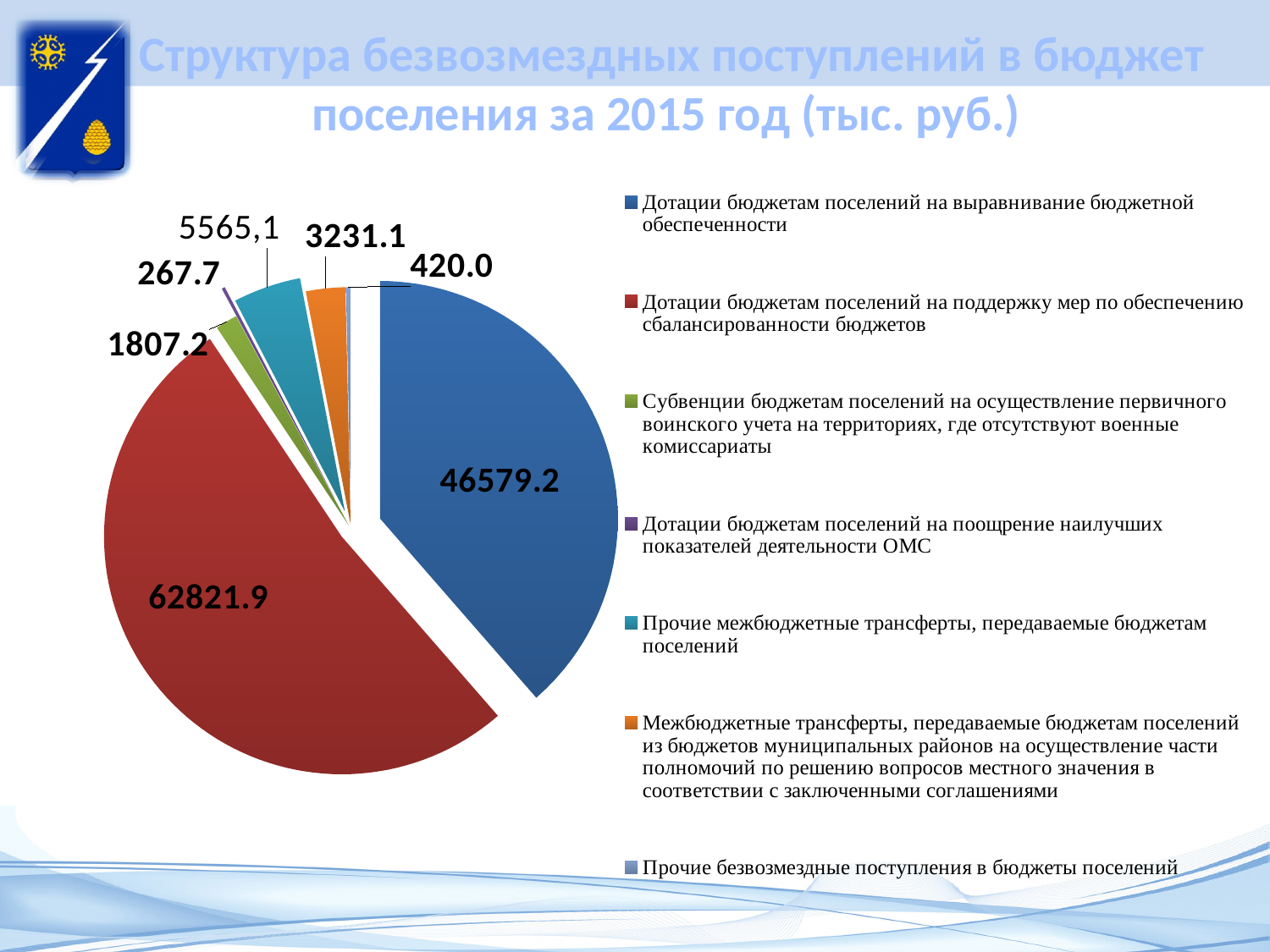
How many entries does the legend list? 7 Which category has the smallest slice of the pie? Дотации бюджетам поселений на поощрение наилучших показателей деятельности ОМС What value is shown for 'Дотации бюджетам поселений на поддержку мер по обеспечению сбалансированности бюджетов'? 62821.9 Which is larger: 'Прочие межбюджетные трансферты, передаваемые бюджетам поселений' or 'Межбюджетные трансферты из бюджетов муниципальных районов'? Прочие межбюджетные трансферты, передаваемые бюджетам поселений What value is shown for 'Прочие безвозмездные поступления в бюджеты поселений'? 420.0 What colour is the slice for 'Дотации бюджетам поселений на выравнивание бюджетной обеспеченности'? Blue What value is shown for 'Дотации бюджетам поселений на выравнивание бюджетной обеспеченности'? 46579.2 How many slices does the pie chart have? 7 What value is shown for 'Субвенции бюджетам поселений на осуществление первичного воинского учета'? 1807.2 What type of chart is shown on the slide? Pie chart What is the difference between the value for 'Дотации на поддержку мер по обеспечению сбалансированности бюджетов' and the value for 'Дотации на выравнивание бюджетной обеспеченности'? 16242.7 Which category has the largest slice of the pie? Дотации бюджетам поселений на поддержку мер по обеспечению сбалансированности бюджетов